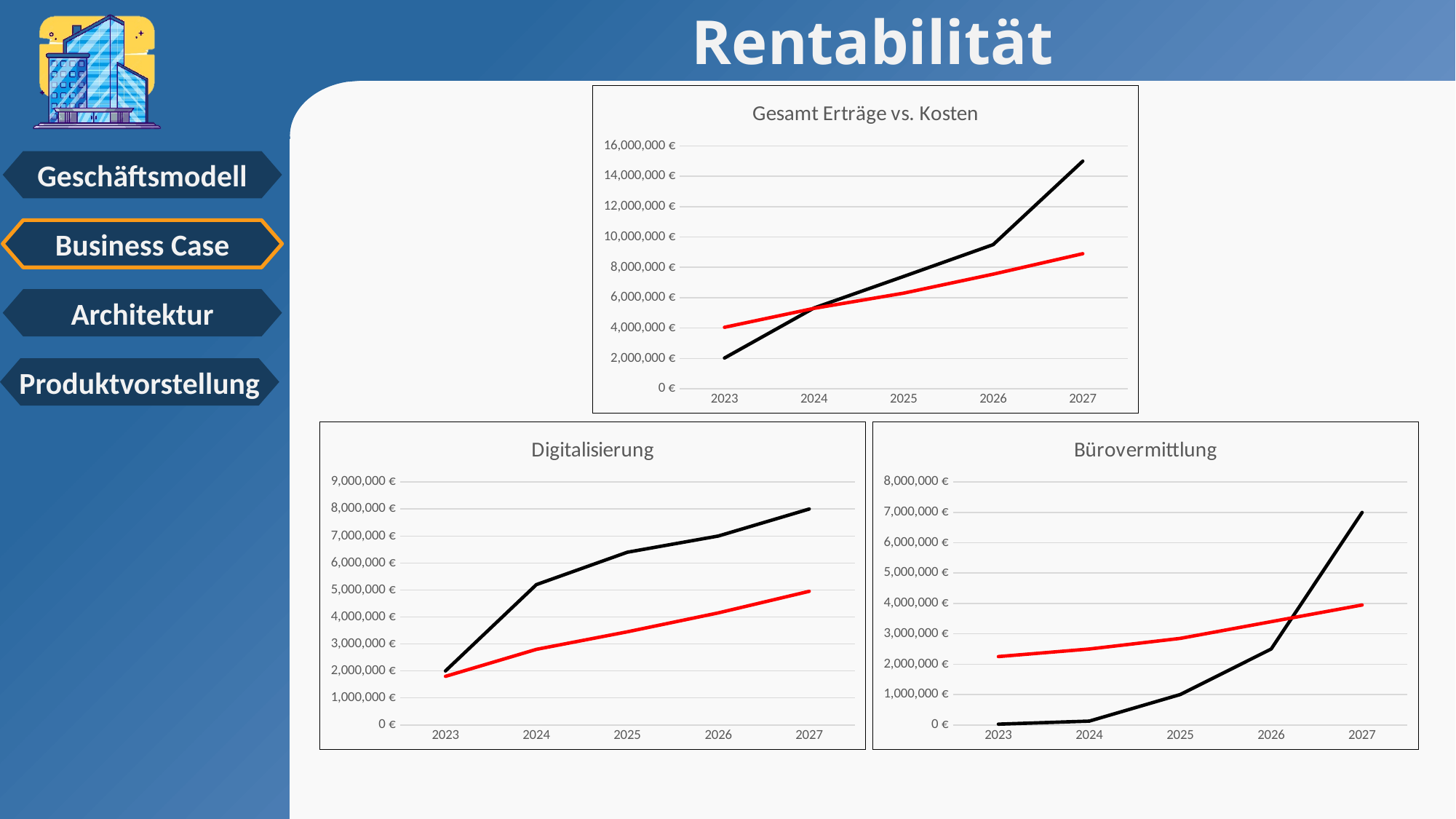
In the 'Bürovermittlung' chart, in which year does the black line reach its highest value? 2027 What is the highest value labelled on the y axis of the 'Gesamt Erträge vs. Kosten' chart? 16,000,000 € What kind of chart is the 'Gesamt Erträge vs. Kosten' chart? line chart In the 'Gesamt Erträge vs. Kosten' chart, how many years are shown on the x axis? 5 In the 'Gesamt Erträge vs. Kosten' chart, is the value of the black line in 2027 greater or less than 14,000,000 €? greater In the 'Bürovermittlung' chart, is the value of the black line in 2023 greater or less than 1,000,000 €? less In the 'Bürovermittlung' chart, which line is higher in 2025, the black line or the red line? the red line In the 'Digitalisierung' chart, is the value of the black line in 2027 greater or less than 7,000,000 €? greater In the 'Gesamt Erträge vs. Kosten' chart, which line is higher in 2023, the black line or the red line? the red line In the 'Gesamt Erträge vs. Kosten' chart, which line is higher in 2027, the black line or the red line? the black line In the 'Gesamt Erträge vs. Kosten' chart, does the black line rise or fall from 2023 to 2027? rise